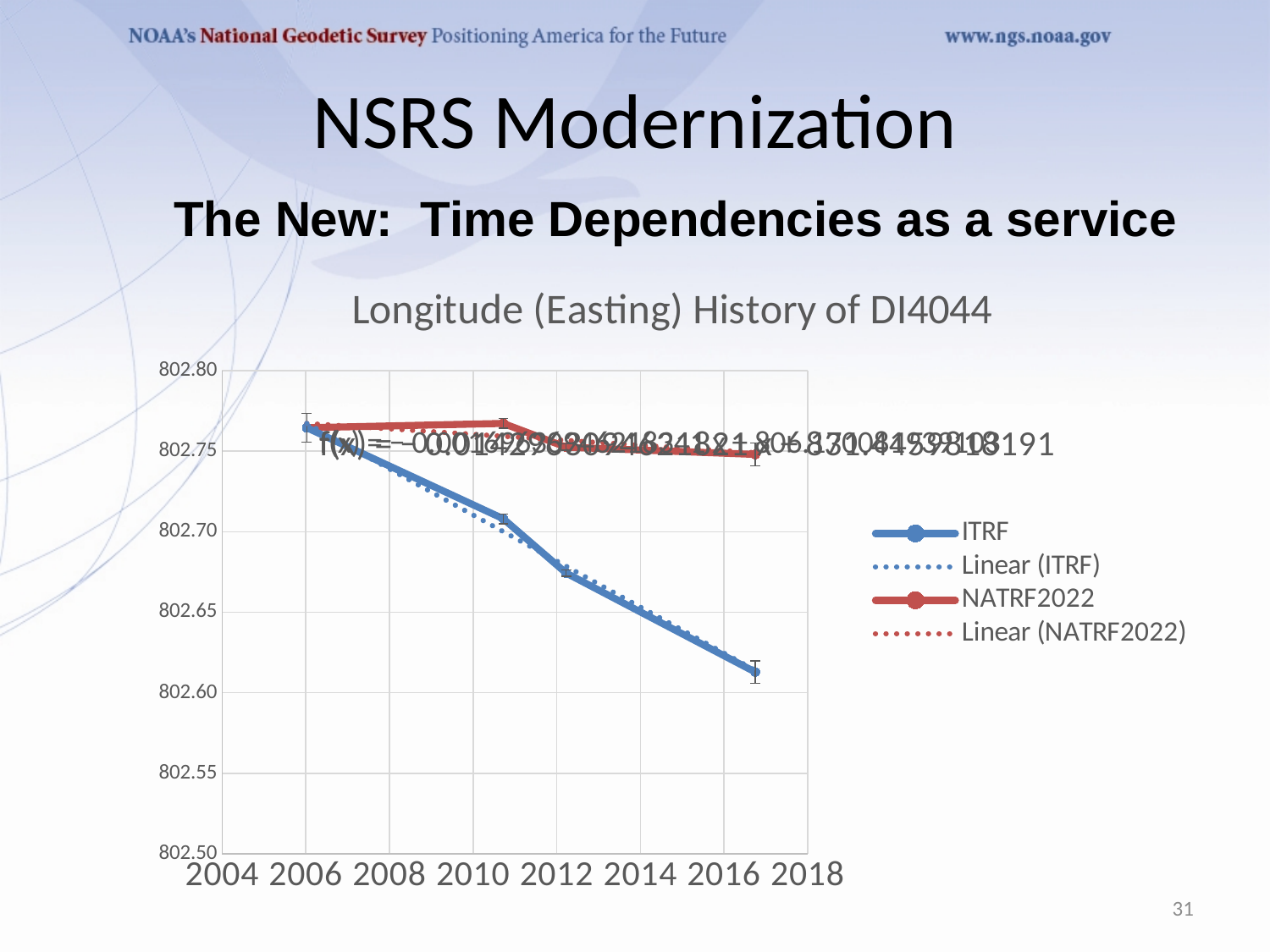
Is the ITRF value at the point around 2012 greater or less than 802.70? less What kind of chart is shown on the slide? line chart How many data points are plotted for the ITRF series? 4 Which two data series (excluding trendlines) are plotted on the chart? ITRF and NATRF2022 How many entries does the chart legend list? 4 Which series is drawn in blue? ITRF Does the ITRF series rise or fall over time along the x axis? fall What is the title of the chart? Longitude (Easting) History of DI4044 At the last plotted point (around 2017), which series has the higher value, ITRF or NATRF2022? NATRF2022 Is the first ITRF value (around 2006) greater or less than 802.75? greater Is the ITRF value at the last plotted point (around 2017) greater or less than 802.65? less